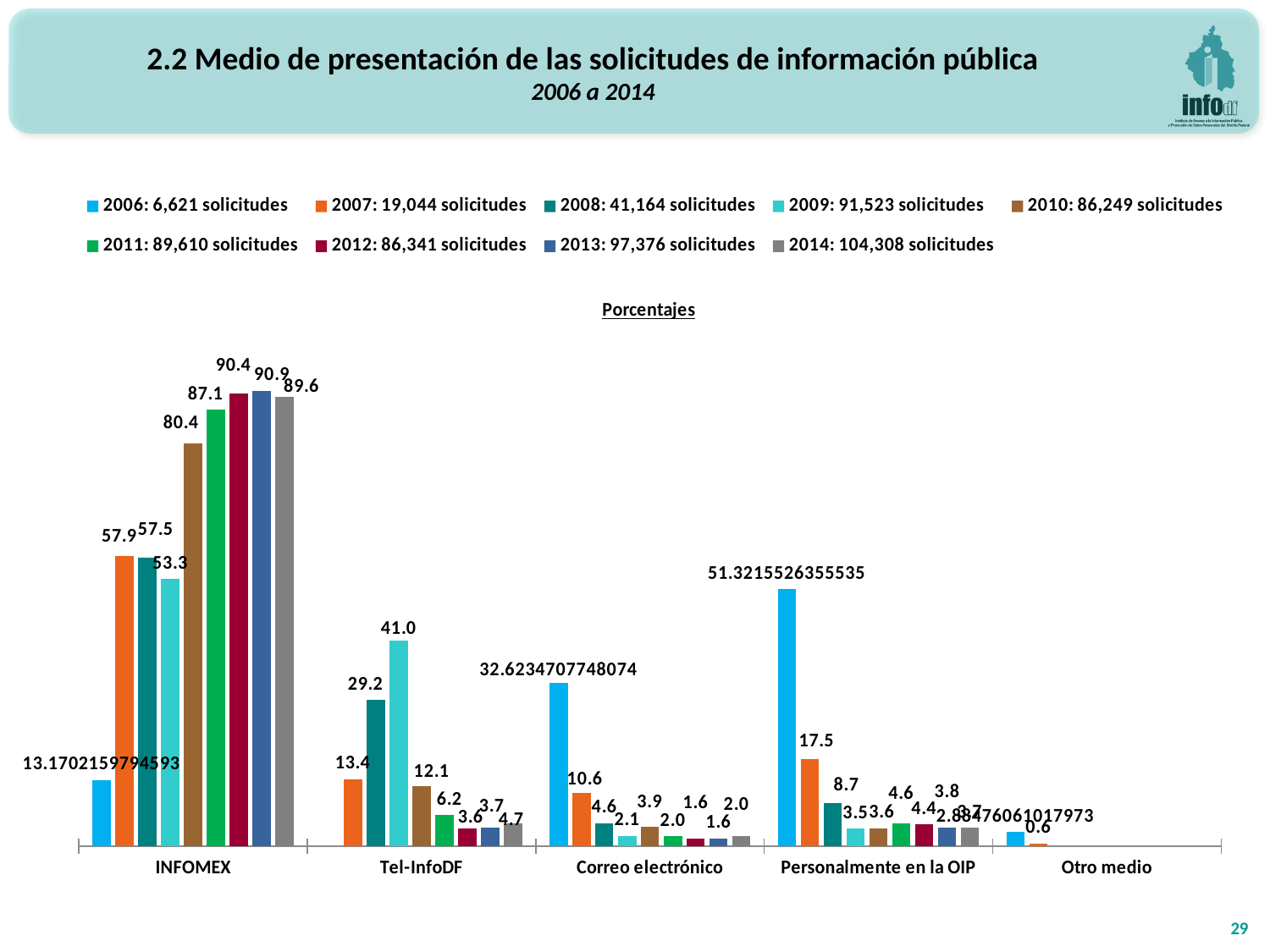
What is the value for INFOMEX in 2013? 90.9 Which category has the highest value for 2014? INFOMEX Do the INFOMEX values rise or fall from 2010 to 2013? rise How many series does the legend list? 9 What is the value for Tel-InfoDF in 2009? 41.0 What is the value for Personalmente en la OIP in 2007? 17.5 What is the difference between the INFOMEX values for 2014 and 2010? 9.2 Which is larger: Tel-InfoDF in 2008 or Correo electrónico in 2007? Tel-InfoDF in 2008 According to the legend, how many solicitudes were there in 2014? 104,308 Which year has the highest value for INFOMEX? 2013 What kind of chart is shown on the slide? bar chart How many categories (medios de presentación) are shown on the x axis? 5